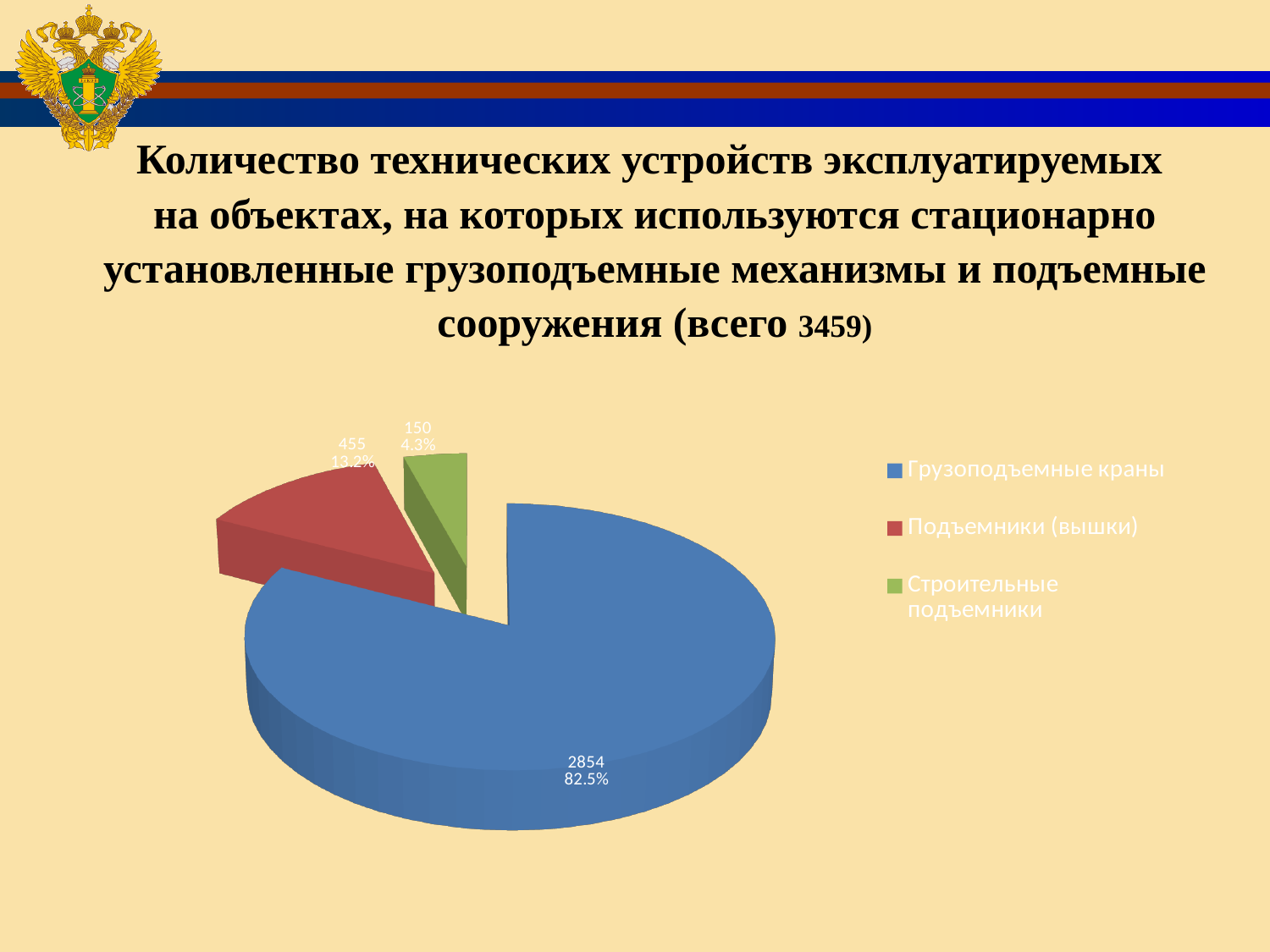
Which category has the smallest slice? Строительные подъемники What is the value for Подъемники (вышки)? 455 Which colour represents Подъемники (вышки) in the chart? red What share of the pie does Строительные подъемники take? 4.3% What is the value for Грузоподъемные краны? 2854 How many slices does the pie chart have? 3 What is the value for Строительные подъемники? 150 How many entries does the legend list? 3 What is the difference between the values for Подъемники (вышки) and Строительные подъемники? 305 What kind of chart is shown on the slide? pie chart Which category has the largest slice? Грузоподъемные краны What share of the pie does Грузоподъемные краны take? 82.5%